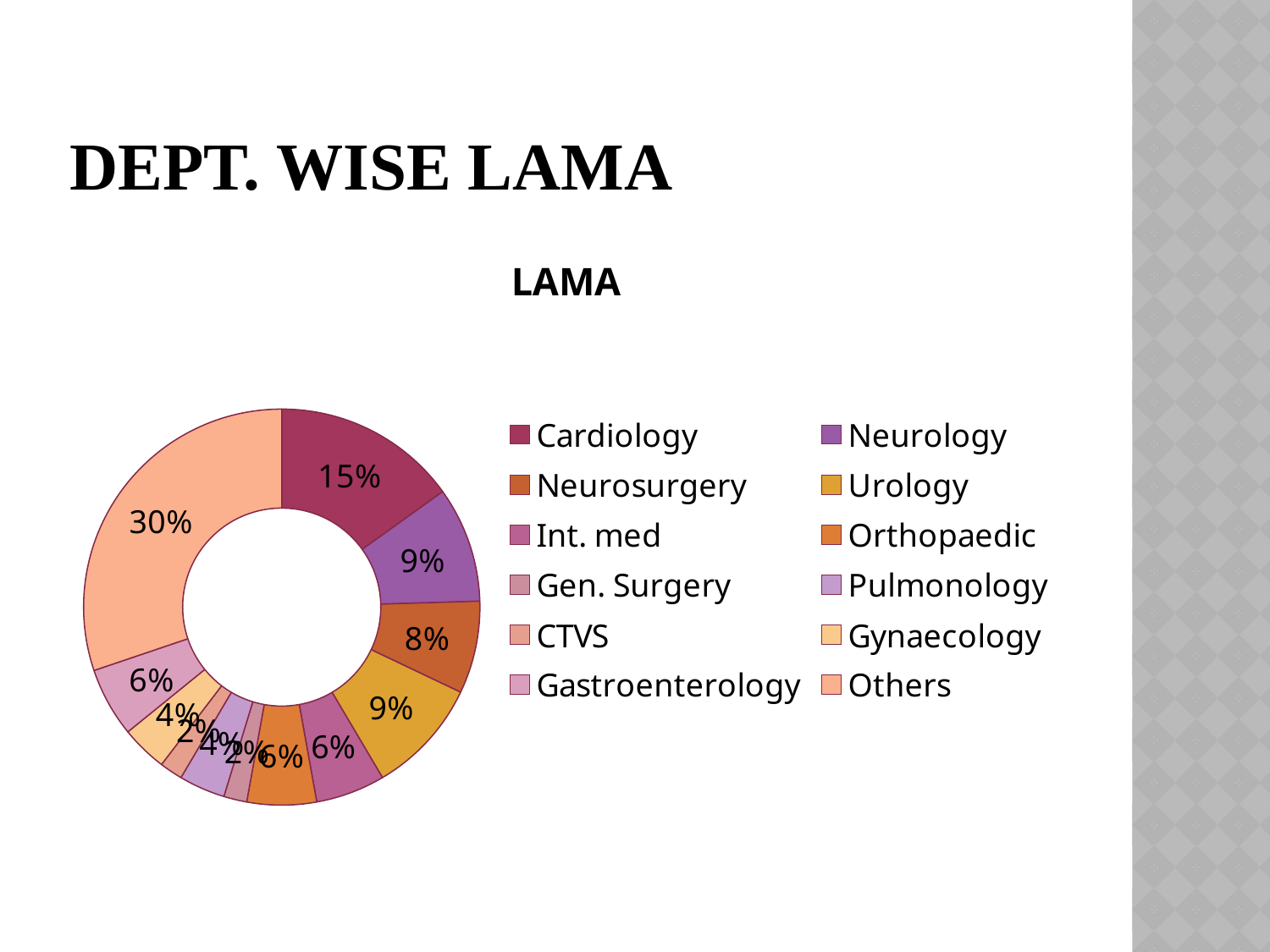
By how many percentage points does the Others share exceed the Cardiology share? 15 percentage points What percentage share does Others have? 30% Which is larger, the share for Cardiology or the share for Neurosurgery? Cardiology How many departments (categories) does the legend list? 12 What is the title of the chart? LAMA What percentage share does Neurology have? 9% What percentage share does Cardiology have? 15% Which category has the largest share of the chart? Others What type of chart is shown on the slide? Doughnut (pie) chart What percentage share does Neurosurgery have? 8% What percentage share does Urology have? 9% What percentage share does Gastroenterology have? 6%